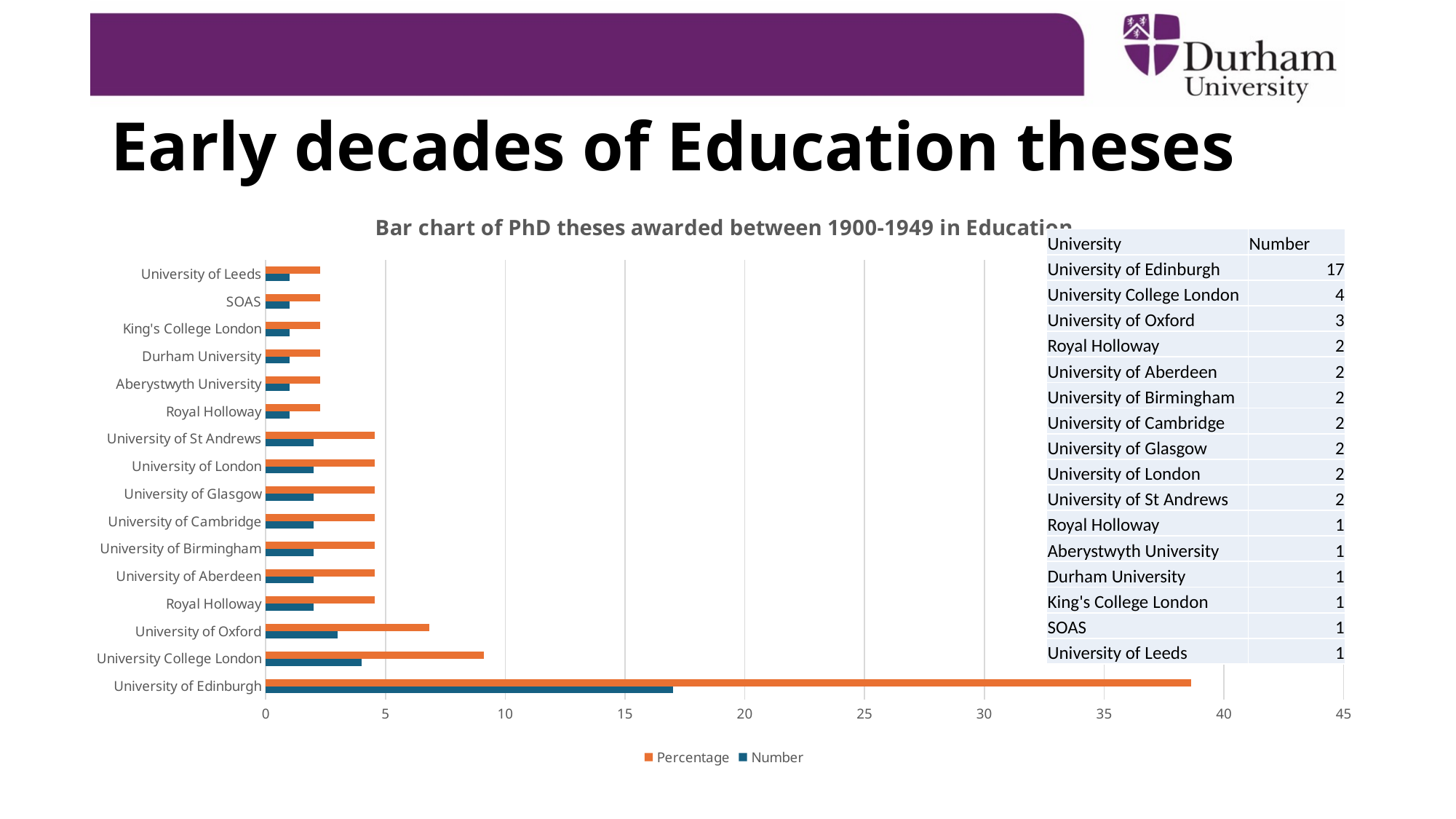
Is the Percentage value for University College London greater or less than 10? less Which has a larger Number value, University College London or the University of Oxford? University College London How many universities are plotted on the chart? 16 What is the Number value for the University of Oxford? 3 What is the Number value for University College London? 4 What kind of chart is shown on the slide? Bar chart What is the difference in Number between the University of Edinburgh and University College London? 13 What are the two entries in the chart's legend? Percentage and Number Is the Percentage value for the University of Edinburgh greater or less than 35? greater What is the Number value for the University of Edinburgh? 17 Which university has the highest Number of PhD theses? University of Edinburgh How many series does the chart's legend list? 2